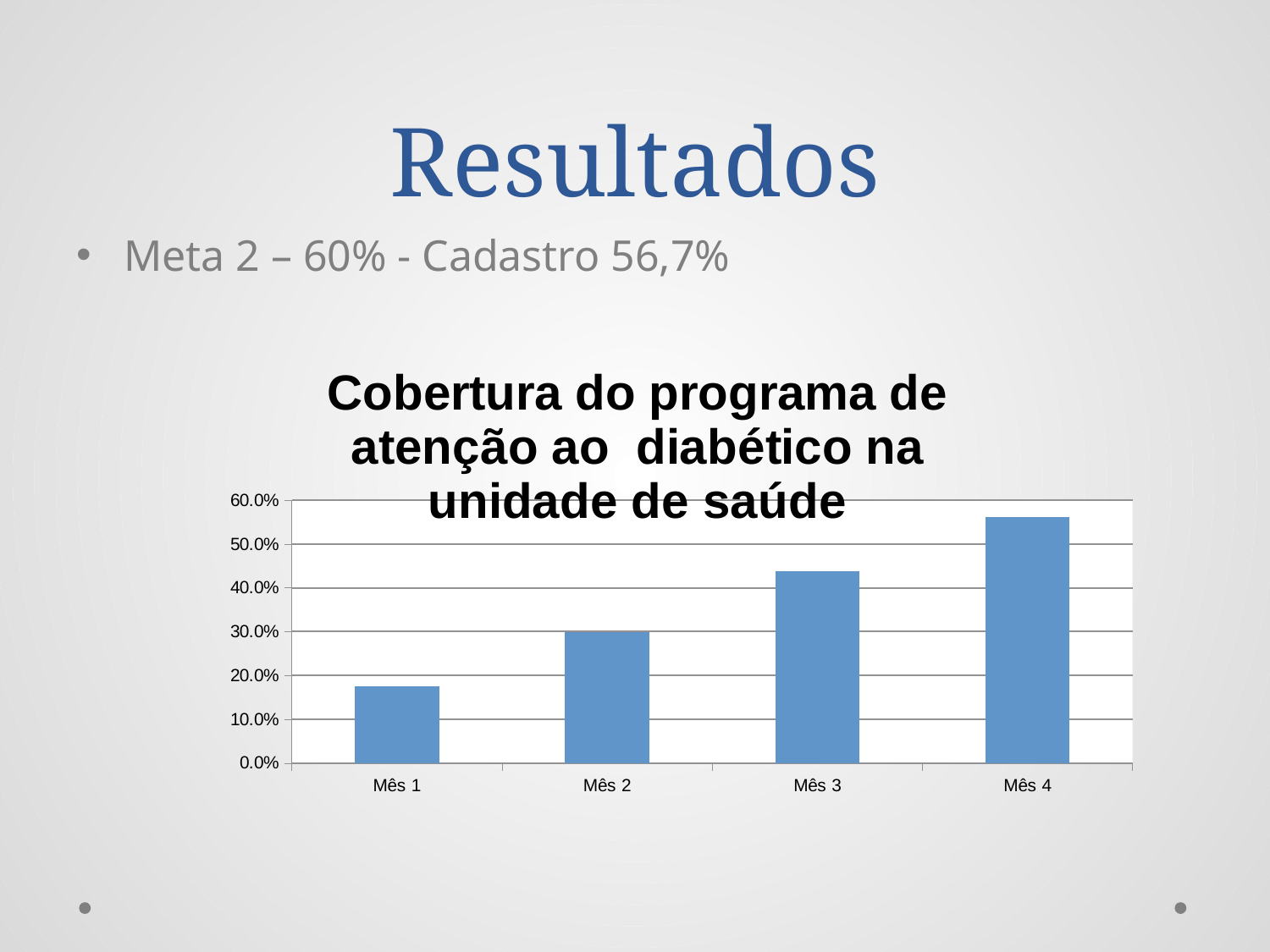
Which is larger, the value for Mês 2 or the value for Mês 3? Mês 3 Is the value for Mês 1 greater or less than 20.0%? less Is the value for Mês 3 greater or less than 40.0%? greater What is the highest value shown on the vertical axis of the chart? 60.0% Do the values rise or fall from Mês 1 to Mês 4? rise How many months (categories) are plotted in the chart? 4 Which month has the highest coverage in the chart? Mês 4 Which month has the lowest coverage in the chart? Mês 1 What is the title of the chart? Cobertura do programa de atenção ao diabético na unidade de saúde Is the value for Mês 4 greater or less than 50.0%? greater What kind of chart is shown on the slide? bar chart